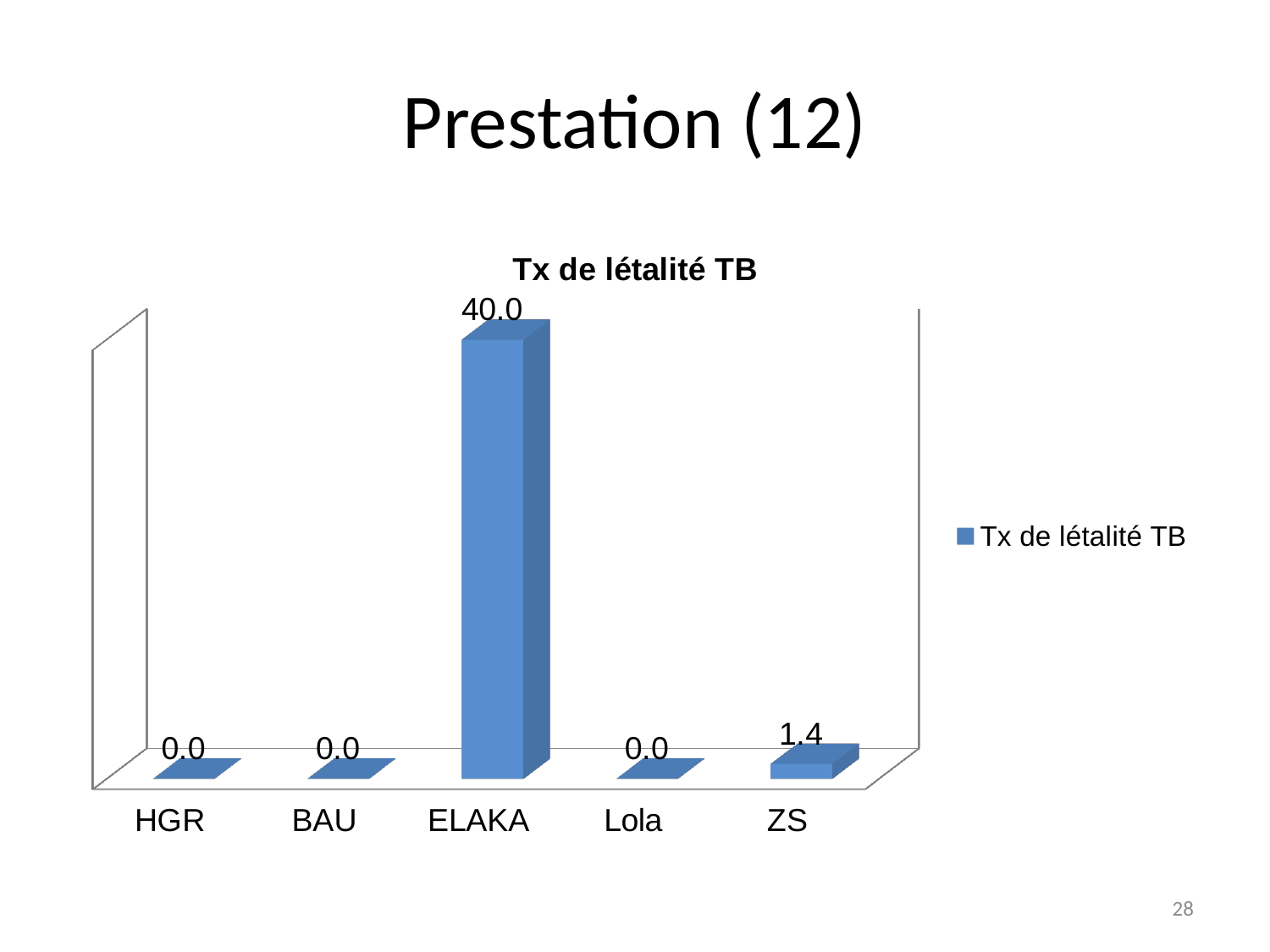
How many categories have a value of 0.0 in the chart? 3 Which is larger, the value for ZS or the value for BAU? ZS Which category has the highest value in the Tx de létalité TB chart? ELAKA How many categories are shown on the x axis of the chart? 5 What kind of chart is shown on the slide? Bar chart What is the value for Lola in the Tx de létalité TB chart? 0.0 What is the value for HGR in the Tx de létalité TB chart? 0.0 What is the value for ZS in the Tx de létalité TB chart? 1.4 What is the difference between the values for ELAKA and ZS? 38.6 How many series does the legend list? 1 What is the value for ELAKA in the Tx de létalité TB chart? 40.0 What is the title of the chart? Tx de létalité TB